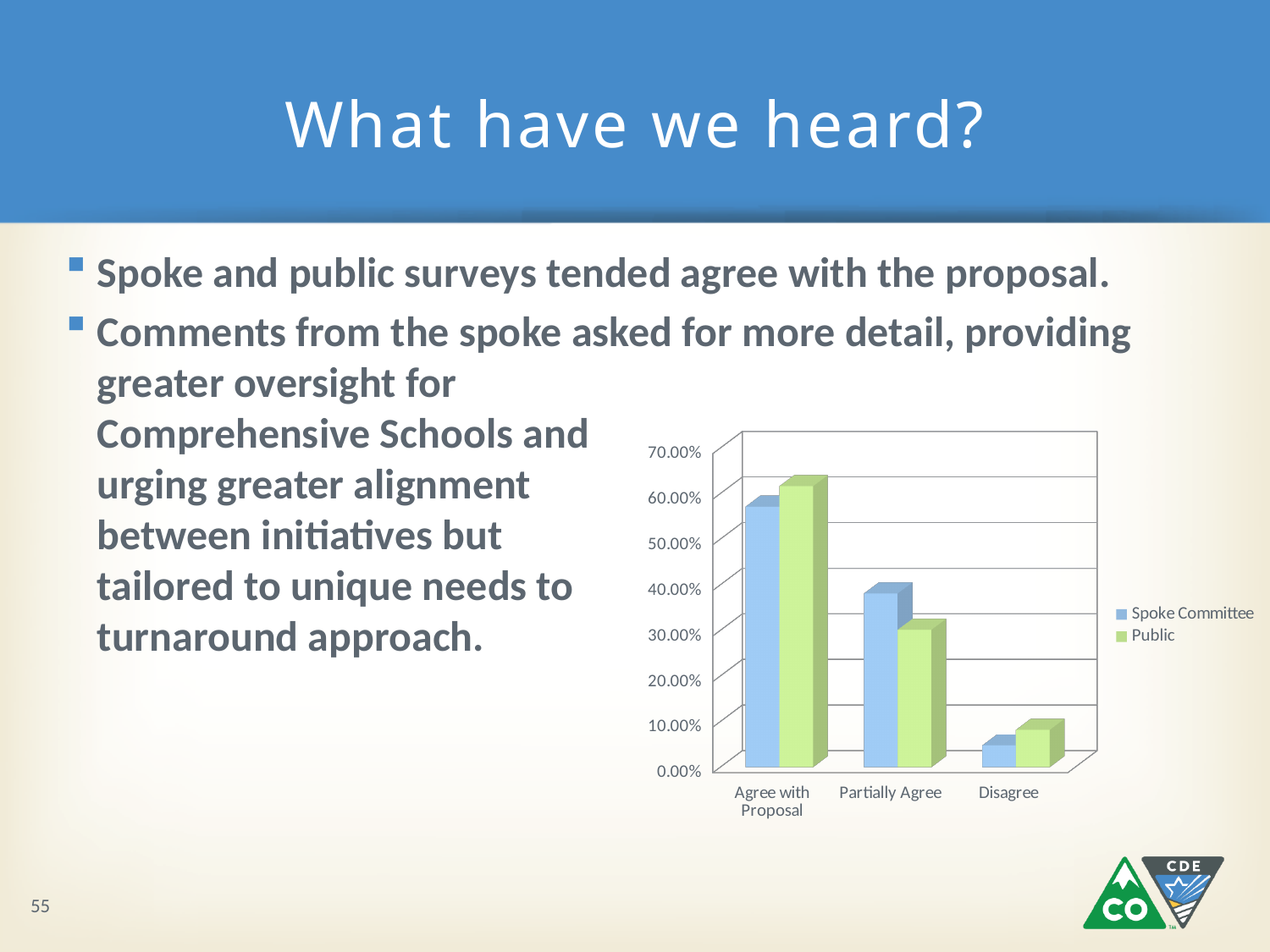
Which category has the highest value for the Spoke Committee series? Agree with Proposal Is the Spoke Committee value for Partially Agree greater or less than 30.00%? greater For Agree with Proposal, which series has the larger value, Spoke Committee or Public? Public Which category has the lowest value for the Public series? Disagree For Partially Agree, which series has the larger value, Spoke Committee or Public? Spoke Committee Is the Spoke Committee value for Agree with Proposal greater or less than 50.00%? greater What kind of chart is shown on the slide? bar chart How many series does the chart's legend list? 2 How many categories are shown on the x axis of the chart? 3 Is the Spoke Committee value for Disagree greater or less than 10.00%? less Do the Public series values rise or fall from Agree with Proposal to Disagree along the x axis? fall